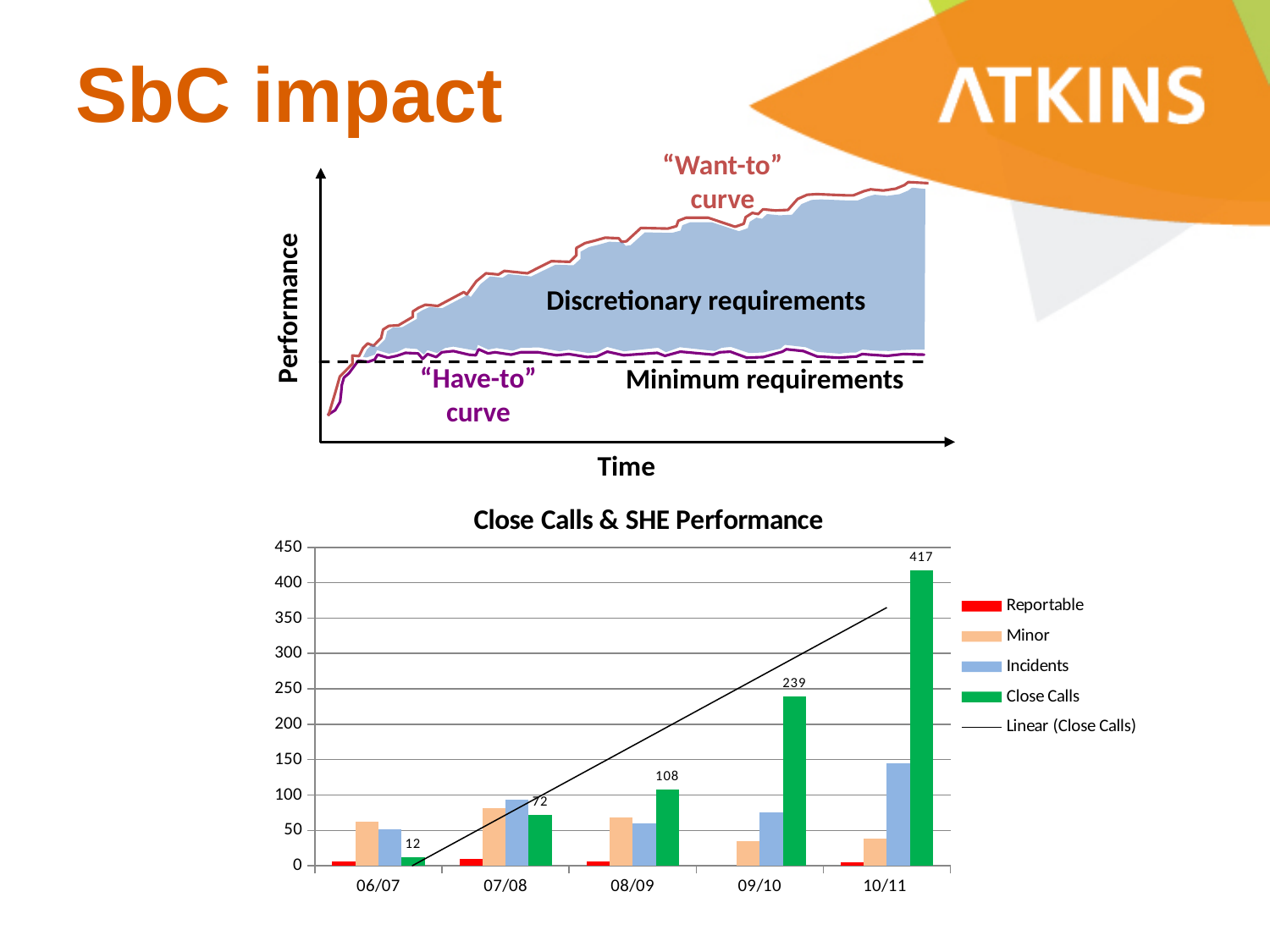
In the 'Close Calls & SHE Performance' chart, which year has the lowest Close Calls value? 06/07 In the 'Close Calls & SHE Performance' chart, do the Close Calls values rise or fall from 06/07 to 10/11? rise How many entries does the legend of the 'Close Calls & SHE Performance' chart list? 5 In the 'Close Calls & SHE Performance' chart, is the Incidents value for 10/11 greater or less than 100? greater In the 'Close Calls & SHE Performance' chart, what is the Close Calls value for 06/07? 12 In the 'Close Calls & SHE Performance' chart, which is larger: Close Calls in 07/08 or Close Calls in 08/09? 08/09 How many year categories are shown on the x axis of the 'Close Calls & SHE Performance' chart? 5 In the 'Close Calls & SHE Performance' chart, what is the Close Calls value for 09/10? 239 In the 'Close Calls & SHE Performance' chart, what is the difference between the Close Calls values for 10/11 and 09/10? 178 In the 'Close Calls & SHE Performance' chart, which year has the highest Close Calls value? 10/11 In the 'Close Calls & SHE Performance' chart, what is the Close Calls value for 10/11? 417 In the 'Close Calls & SHE Performance' chart, is the Minor value for 06/07 greater or less than 50? greater